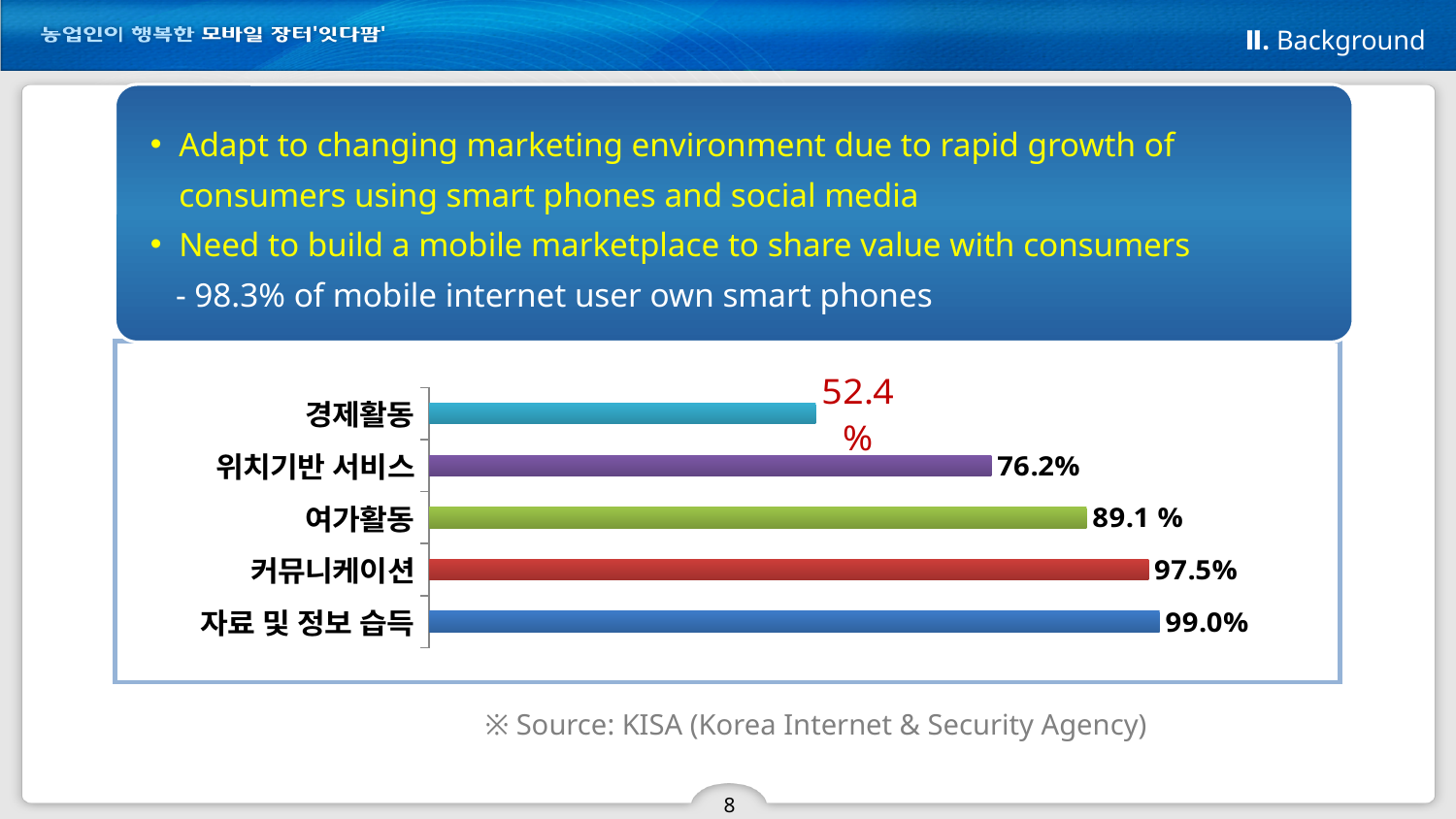
Which is larger, the value for 위치기반 서비스 or the value for 여가활동? 여가활동 How many categories are shown in the chart? 5 What is the value for 위치기반 서비스? 76.2% What is the value for 커뮤니케이션? 97.5% Which category has the lowest value? 경제활동 What is the value for 경제활동? 52.4% Which category has the highest value? 자료 및 정보 습득 What kind of chart is shown on the slide? Bar chart What is the difference between the values for 자료 및 정보 습득 and 커뮤니케이션? 1.5 percentage points What is the value for 여가활동? 89.1 % What is the difference between the values for 여가활동 and 경제활동? 36.7 percentage points What is the value for 자료 및 정보 습득? 99.0%